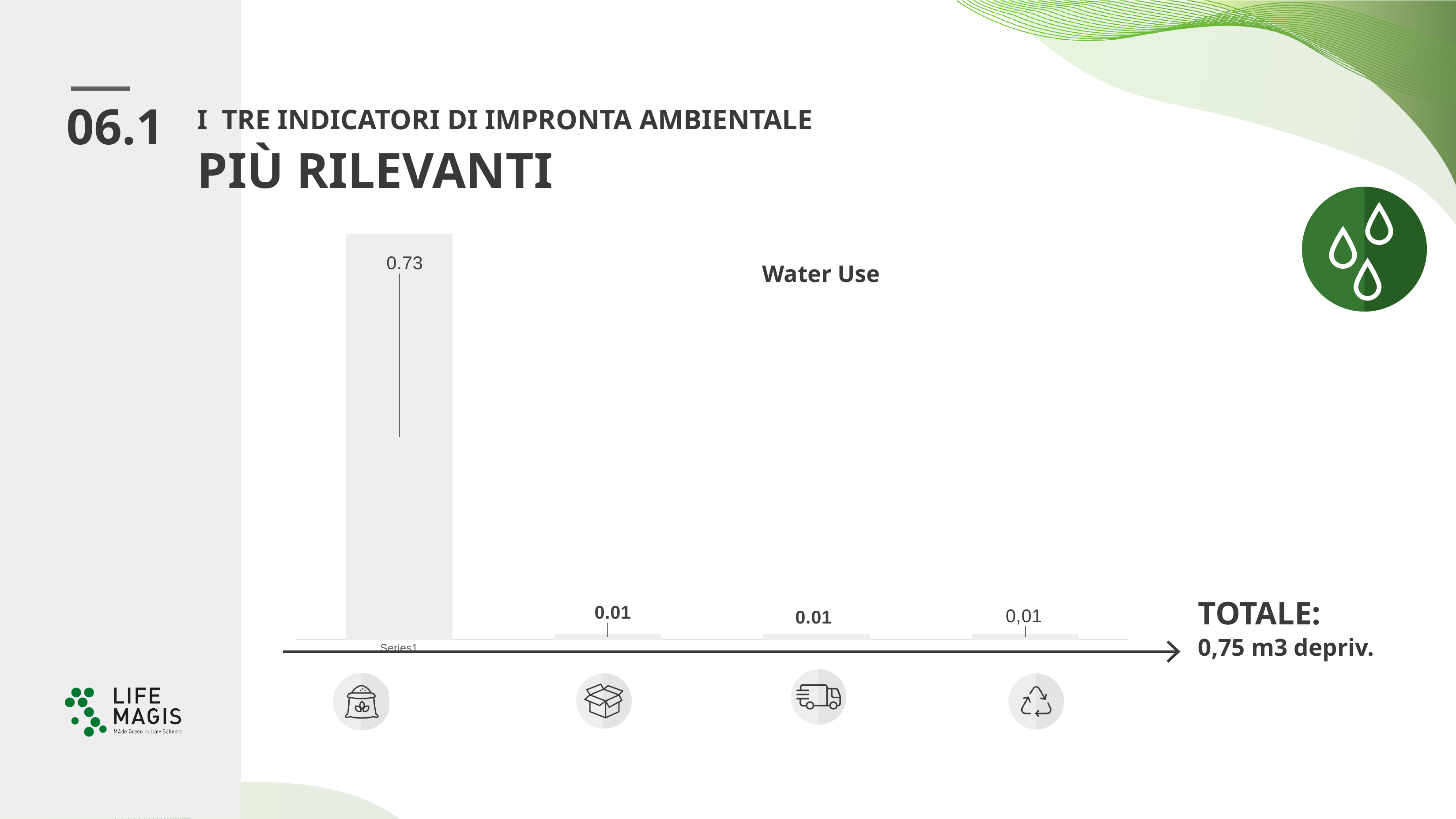
What is the value shown on the second bar from the left in the Water Use chart? 0.01 What is the value of the leftmost bar, labelled Series1, in the Water Use chart? 0.73 What is the difference between the leftmost bar (0.73) and the second bar (0.01) in the Water Use chart? 0.72 What is the value shown on the rightmost bar in the Water Use chart? 0,01 What total value is printed next to the Water Use chart? 0,75 m3 depriv. What is the value shown on the tallest bar in the Water Use chart? 0.73 What kind of chart is shown on the slide? bar chart Do the bar values rise or fall from the first bar to the second bar in the Water Use chart? fall How many bars are plotted in the Water Use chart? 4 What is the title of the chart? Water Use Which bar is the tallest in the Water Use chart: the leftmost bar or the rightmost bar? the leftmost bar